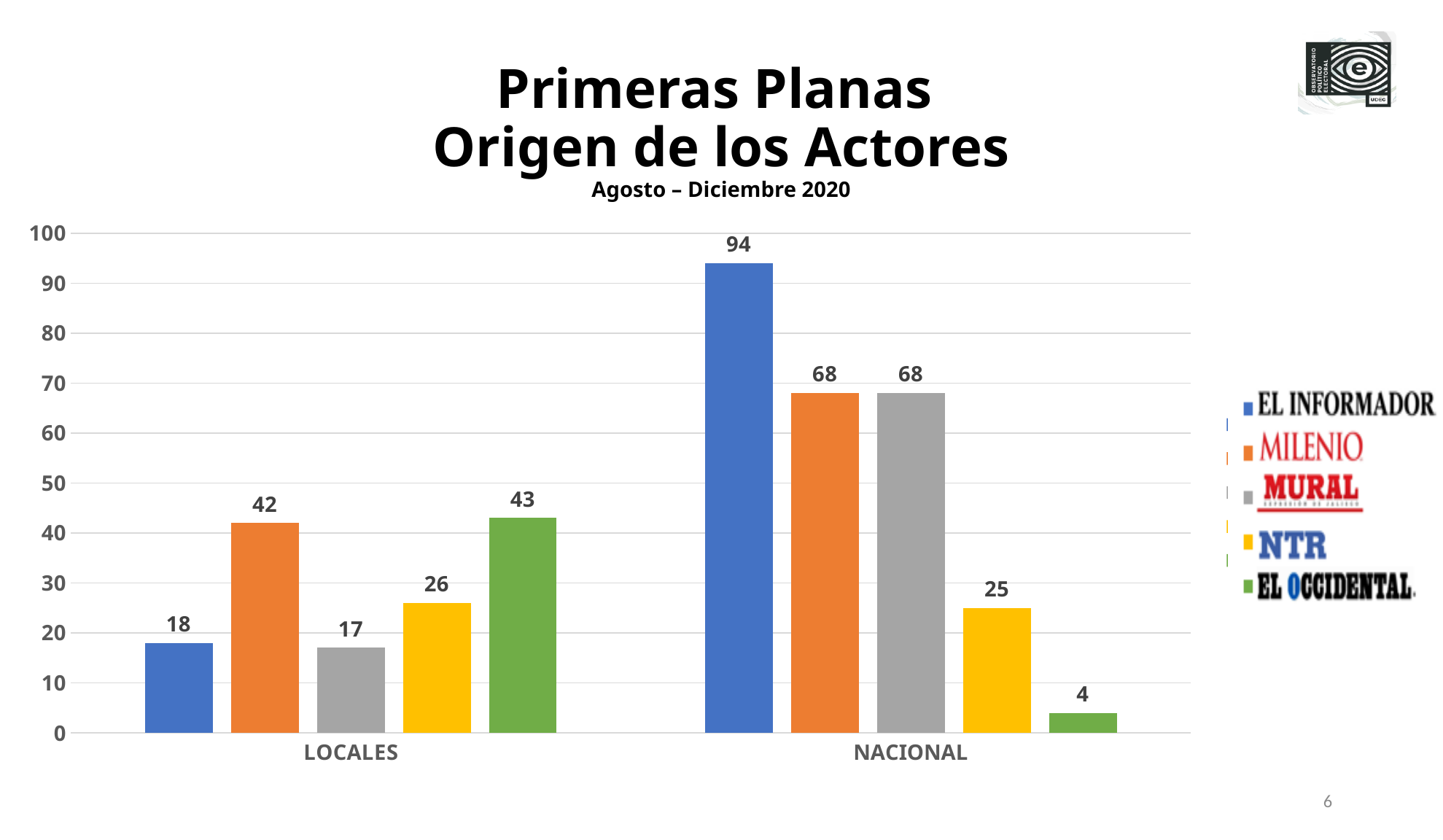
Which series has the lowest value in the LOCALES category? Mural What is the value for El Informador in the NACIONAL category? 94 Is the value for Milenio in the NACIONAL category greater or less than 60? greater How many categories are shown on the x axis? 2 What is the value for NTR in the NACIONAL category? 25 What period does the chart subtitle cover? Agosto – Diciembre 2020 What is the difference between El Informador's NACIONAL value and its LOCALES value? 76 How many series does the legend list? 5 What is the value for El Occidental in the LOCALES category? 43 Which is larger: Milenio's value for LOCALES or El Occidental's value for LOCALES? El Occidental What kind of chart is shown on the slide? bar chart Which series has the highest value in the NACIONAL category? El Informador